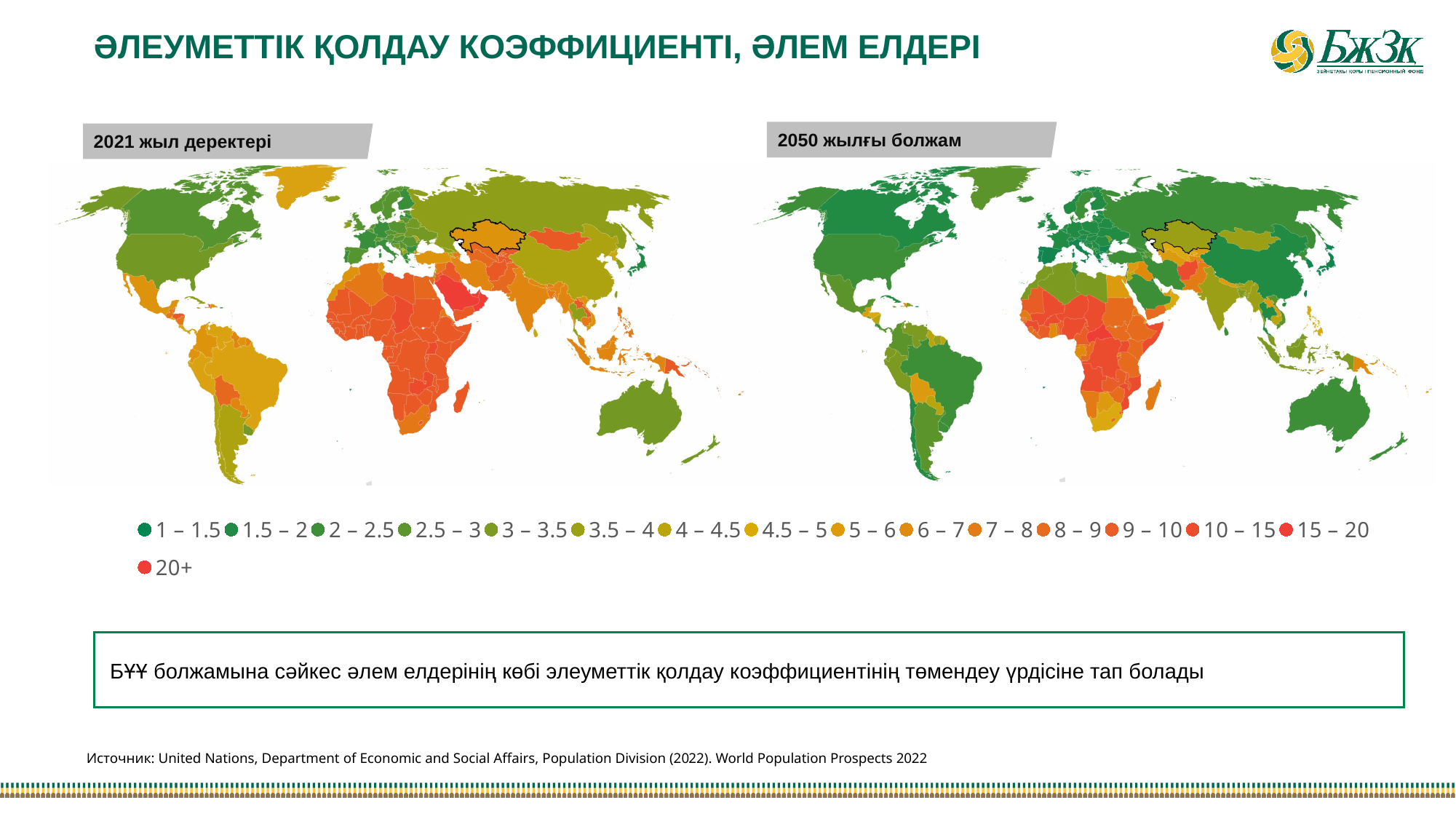
What is the label of the right map? 2050 жылғы болжам How many maps are shown on the slide? 2 What kind of chart is shown on the slide? Map chart (choropleth world maps) What is the lowest value range shown in the legend? 1 – 1.5 How many value ranges does the legend list? 16 What is the label of the left map? 2021 жыл деректері What is the highest value range shown in the legend? 20+